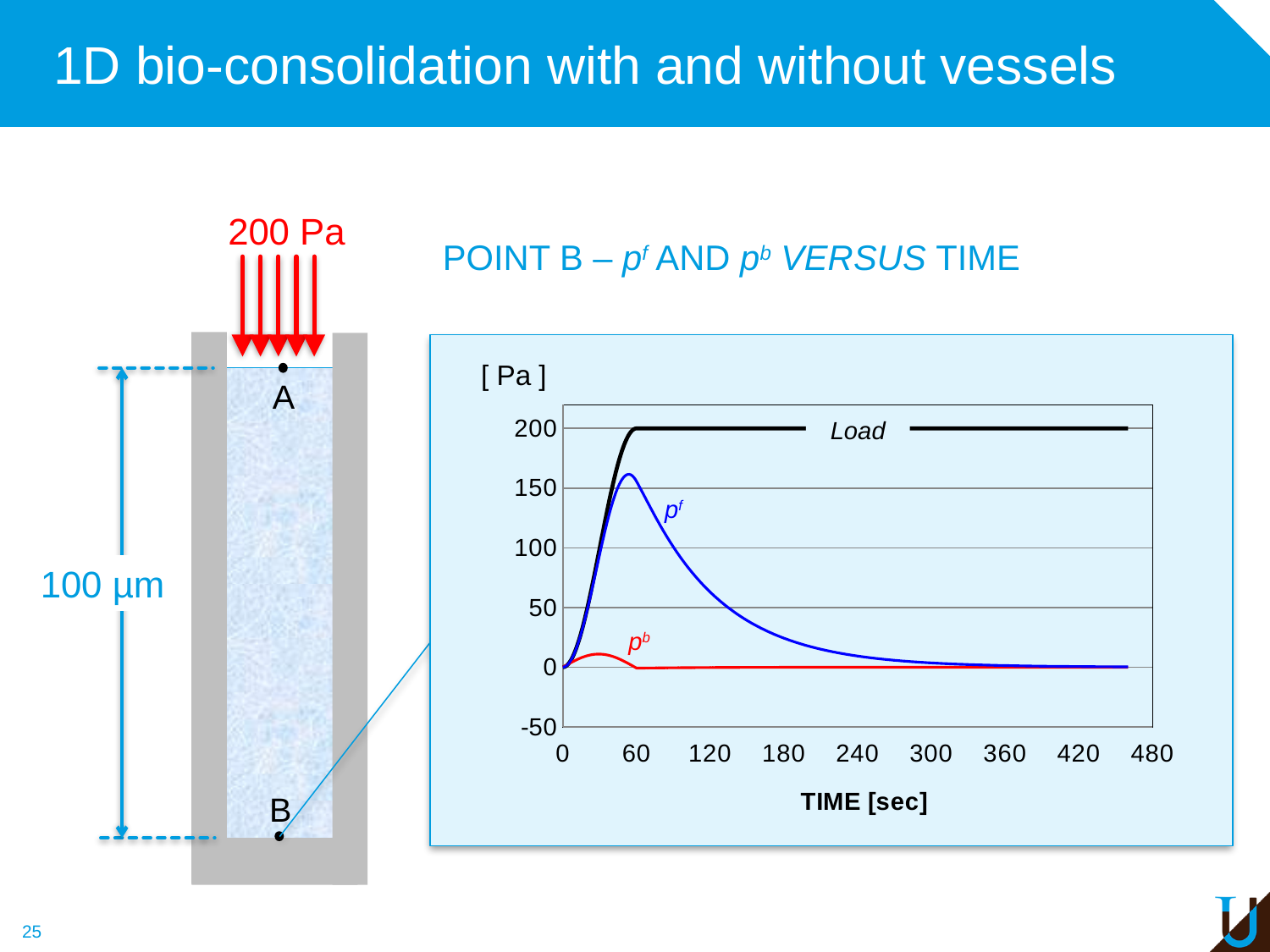
Is the peak value of the p^f curve greater or less than 150? greater Is the peak value of the p^b curve greater or less than 50? less What kind of chart is shown on the slide? line chart What unit is shown on the y axis of the chart? Pa At 120 seconds, which is larger, the Load value or the p^f value? Load Does the p^f curve rise or fall between 60 and 300 seconds? fall Which curve has the highest value at 240 seconds? Load At what value does the Load curve level off after about 60 seconds? 200 What is the largest tick value shown on the x axis? 480 Which curve has the lowest peak value? p^b What is the label of the x axis of the chart? TIME [sec] How many curves are plotted in the chart? 3